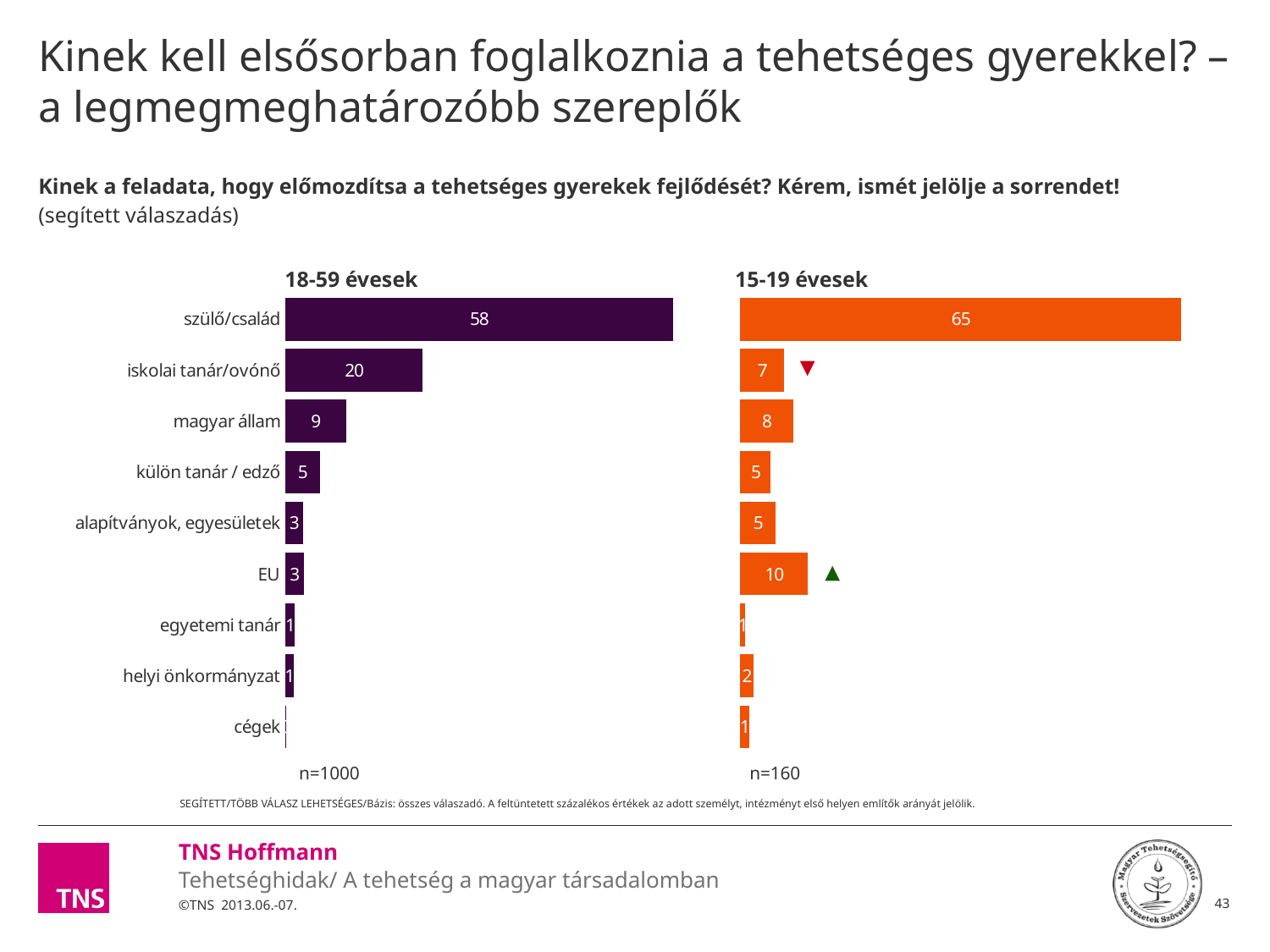
In the "15-19 évesek" chart, which is larger: EU or magyar állam? EU What is the difference between the szülő/család values in the "15-19 évesek" chart and the "18-59 évesek" chart? 7 In the "15-19 évesek" chart, which category has the highest value? szülő/család In the "15-19 évesek" chart, what is the value for EU? 10 How many categories are shown in the "18-59 évesek" chart? 9 Which is larger: the value for iskolai tanár/ovónő in the "18-59 évesek" chart or in the "15-19 évesek" chart? 18-59 évesek In the "18-59 évesek" chart, what is the difference between iskolai tanár/ovónő and magyar állam? 11 In the "18-59 évesek" chart, what is the value for magyar állam? 9 In the "18-59 évesek" chart, what is the value for szülő/család? 58 What kind of chart is the "15-19 évesek" chart? bar chart In the "15-19 évesek" chart, what is the value for iskolai tanár/ovónő? 7 In the "18-59 évesek" chart, which category has the highest value? szülő/család